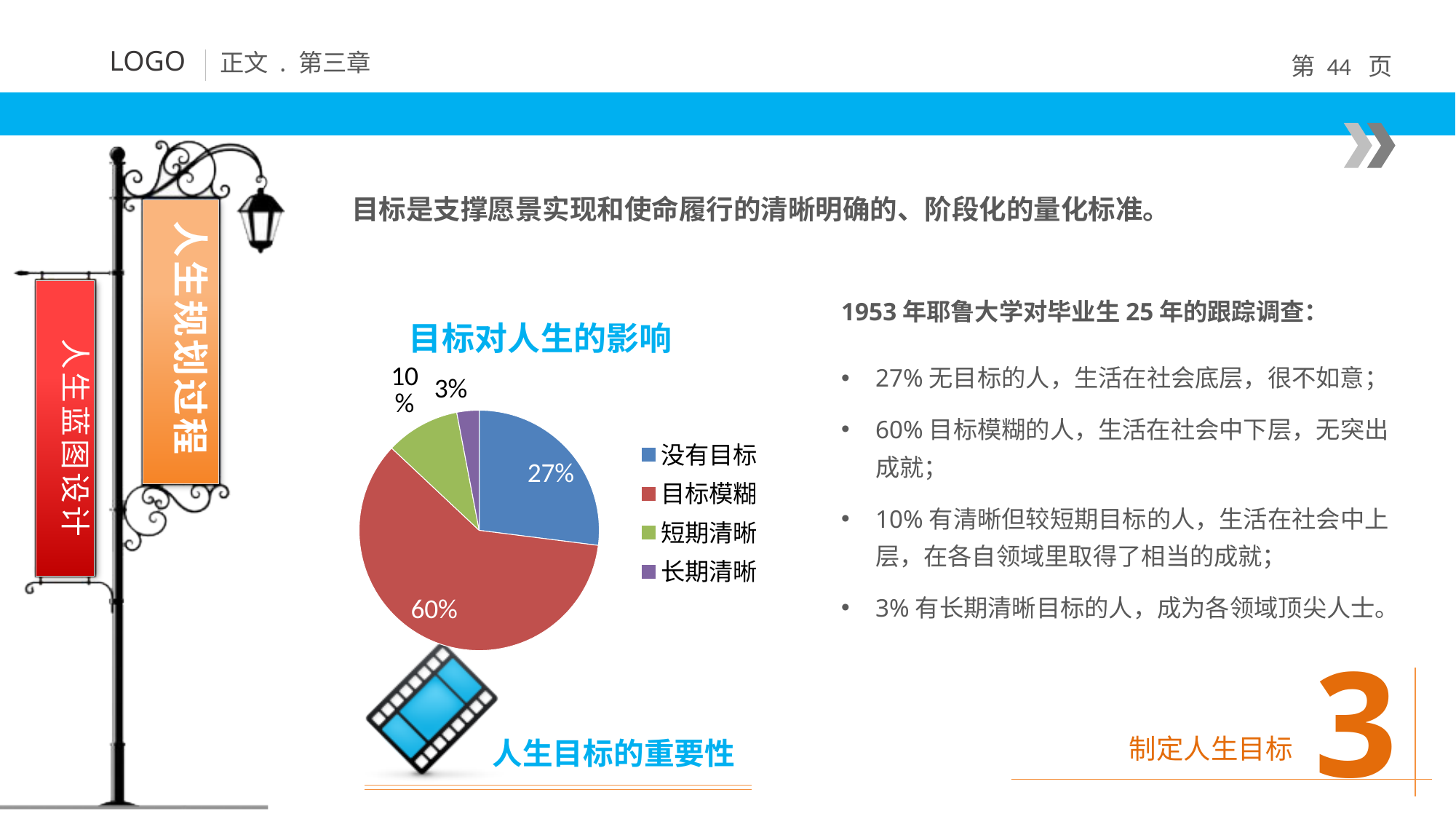
What kind of chart is shown on the slide? pie chart What is the title of the chart? 目标对人生的影响 Which category has the largest slice of the pie? 目标模糊 Which category has the smallest slice of the pie? 长期清晰 What is the difference in percentage points between 目标模糊 and 没有目标? 33 What percentage of the pie is labelled for 目标模糊? 60% What percentage of the pie is labelled for 短期清晰? 10% How many slices does the pie chart have? 4 What percentage of the pie is labelled for 没有目标? 27% What percentage of the pie is labelled for 长期清晰? 3% How many entries does the legend list? 4 Which is larger, the slice for 没有目标 or the slice for 短期清晰? 没有目标